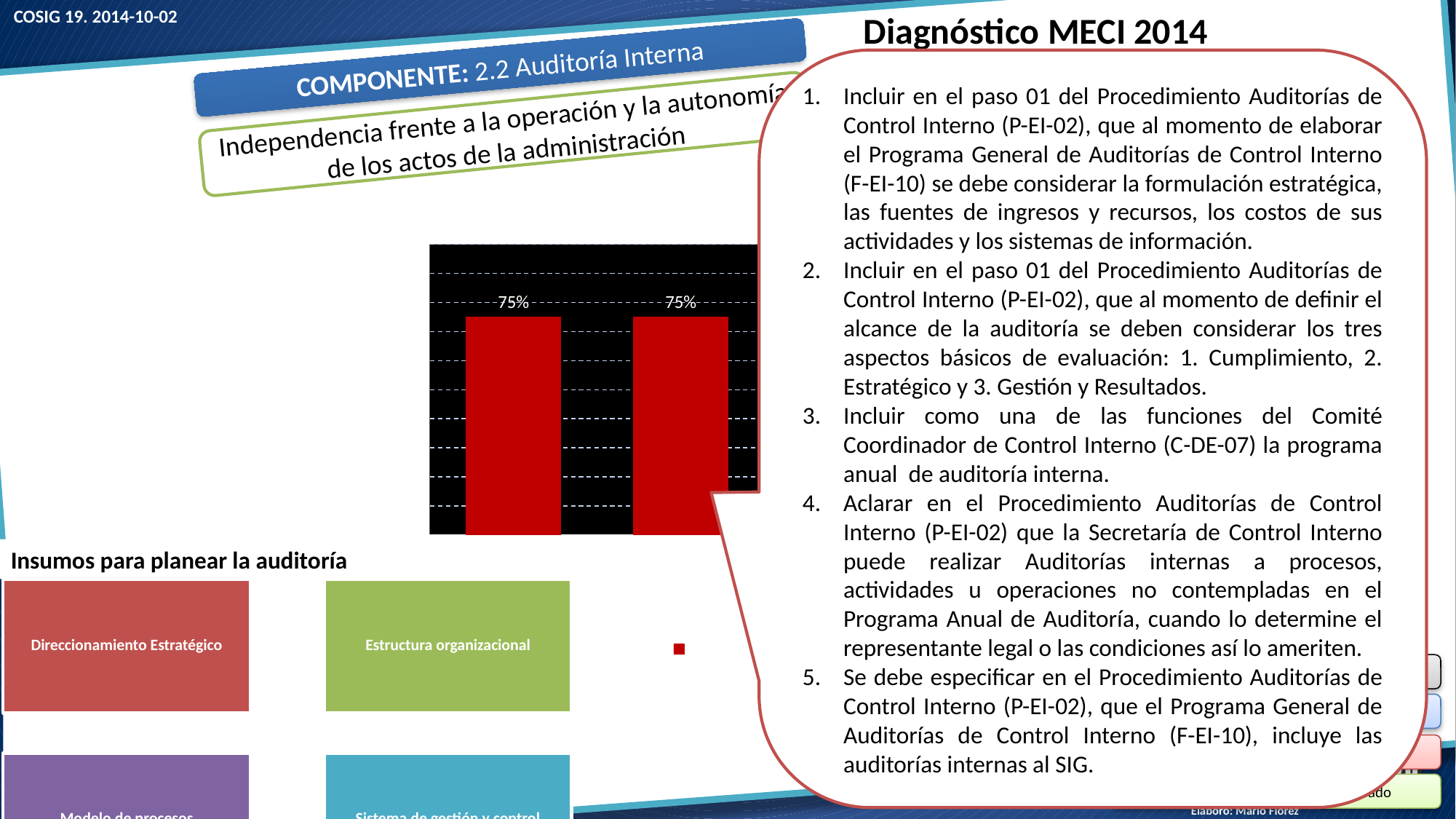
What is the difference between the values of the left and right bars? 0% What kind of chart is shown in the middle of the slide? bar chart What colour is the plot area background of the chart? black What colour are the bars in the chart? red What value is printed above the left bar of the chart? 75% What value is printed above the right bar of the chart? 75% Do the two bars in the chart show the same value? yes